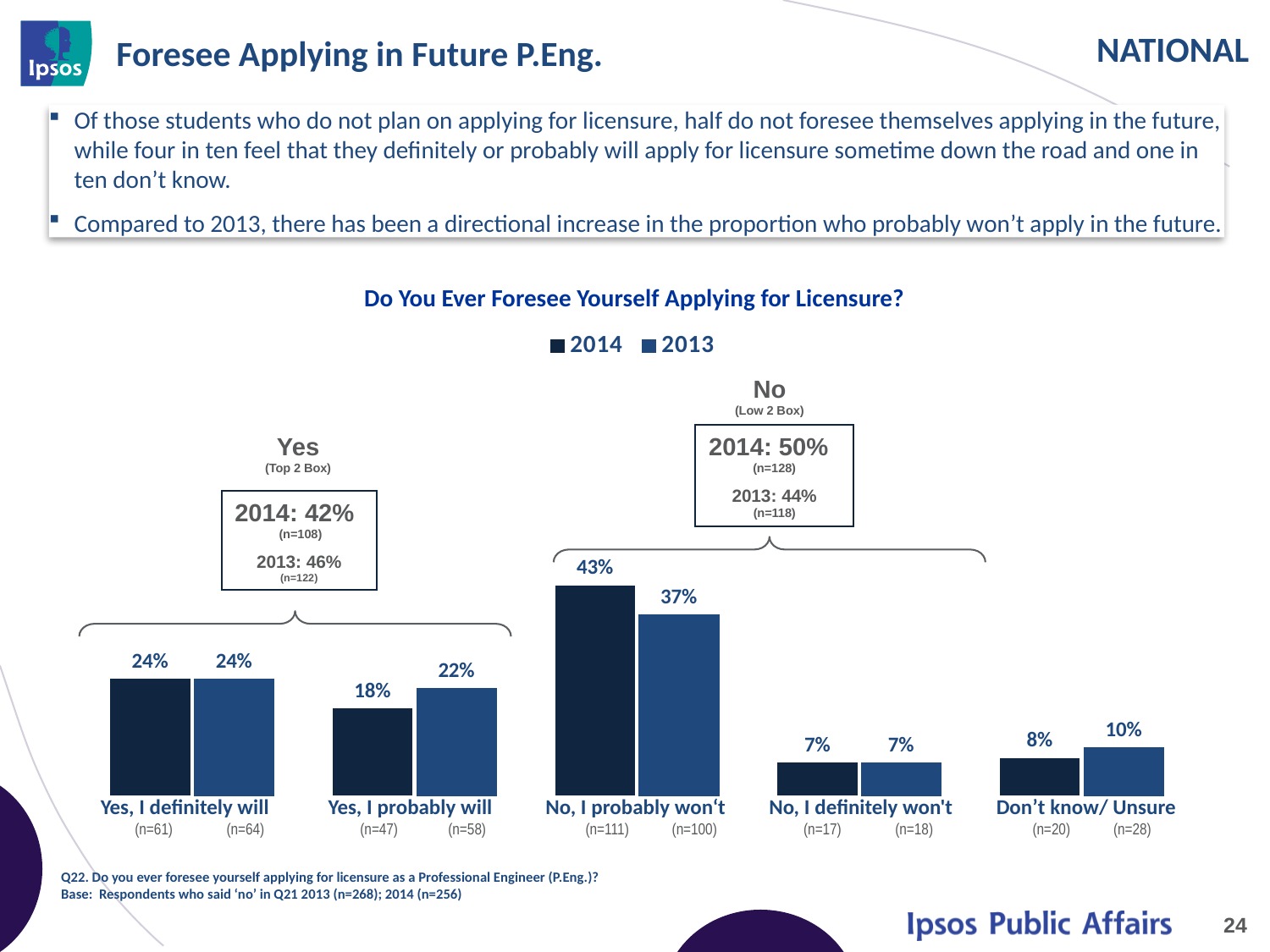
What is the difference between the 2014 and 2013 values for "No, I probably won't"? 6% How many series does the legend list? 2 What is the title of the chart? Do You Ever Foresee Yourself Applying for Licensure? What is the 2013 value for "Yes, I probably will"? 22% How many categories are shown on the x axis? 5 Which category has the lowest 2013 value? No, I definitely won't What kind of chart is shown? Bar chart Which category has the highest 2014 value? No, I probably won't Which is larger for "Yes, I probably will": the 2014 value or the 2013 value? 2013 What is the 2014 value for "No, I probably won't"? 43% What is the 2013 value for "Don't know/ Unsure"? 10% What is the 2014 "No (Low 2 Box)" total shown in the callout? 50%